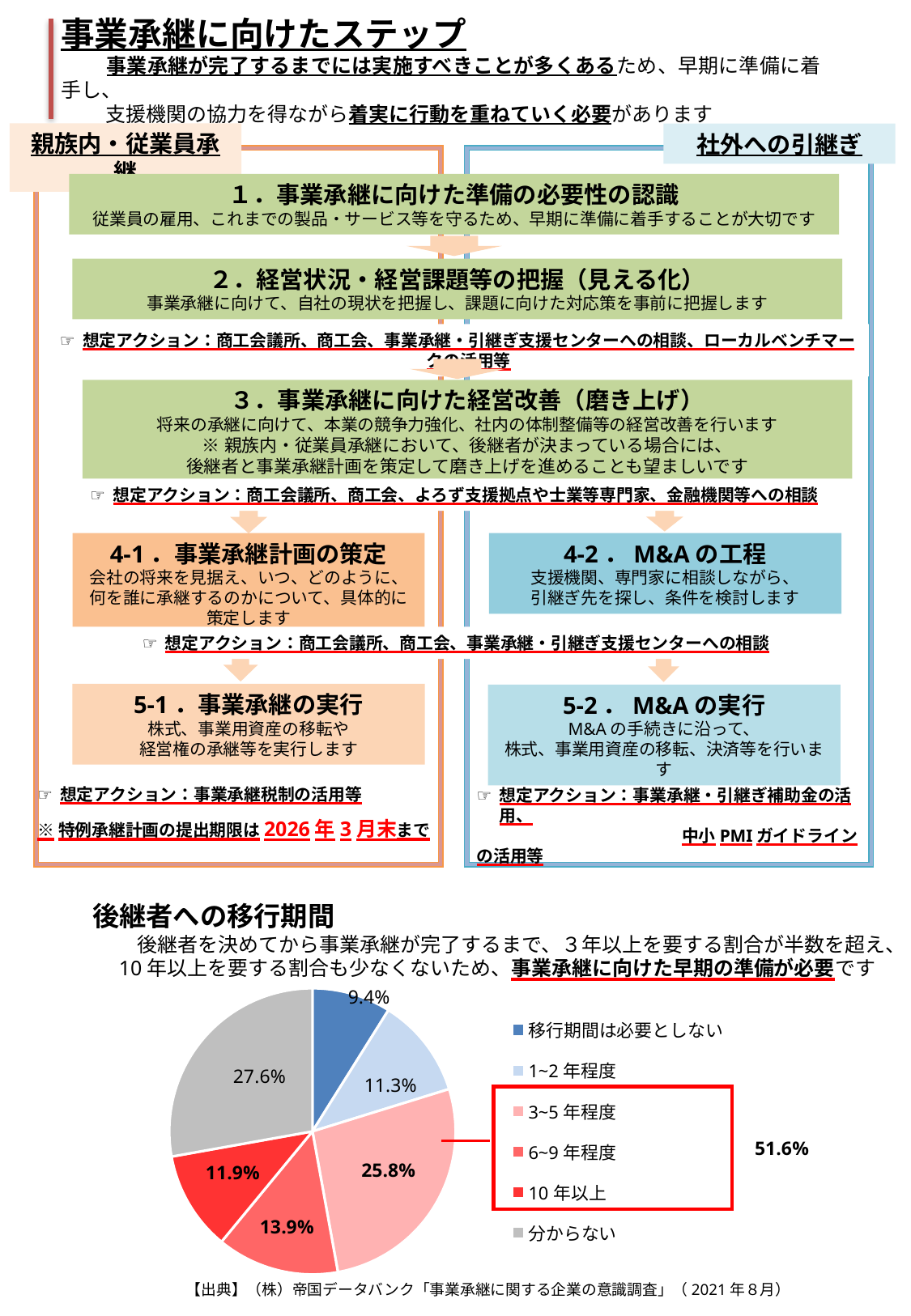
In the pie chart, what share is shown for 分からない? 27.6% What kind of chart is shown under the heading 後継者への移行期間? pie chart In the pie chart, what share is shown for 3~5年程度? 25.8% Which category has the largest slice in the pie chart? 分からない In the pie chart, what share is shown for 移行期間は必要としない? 9.4% In the pie chart, what share is shown for 6~9年程度? 13.9% What combined percentage is shown next to the red box grouping 3~5年程度, 6~9年程度 and 10年以上 in the legend? 51.6% How many categories does the pie chart's legend list? 6 In the pie chart, what share is shown for 10年以上? 11.9% What is the difference between the shares for 3~5年程度 and 1~2年程度 in the pie chart? 14.5% Which category has the smallest slice in the pie chart? 移行期間は必要としない Which is larger in the pie chart, the share for 6~9年程度 or the share for 10年以上? 6~9年程度